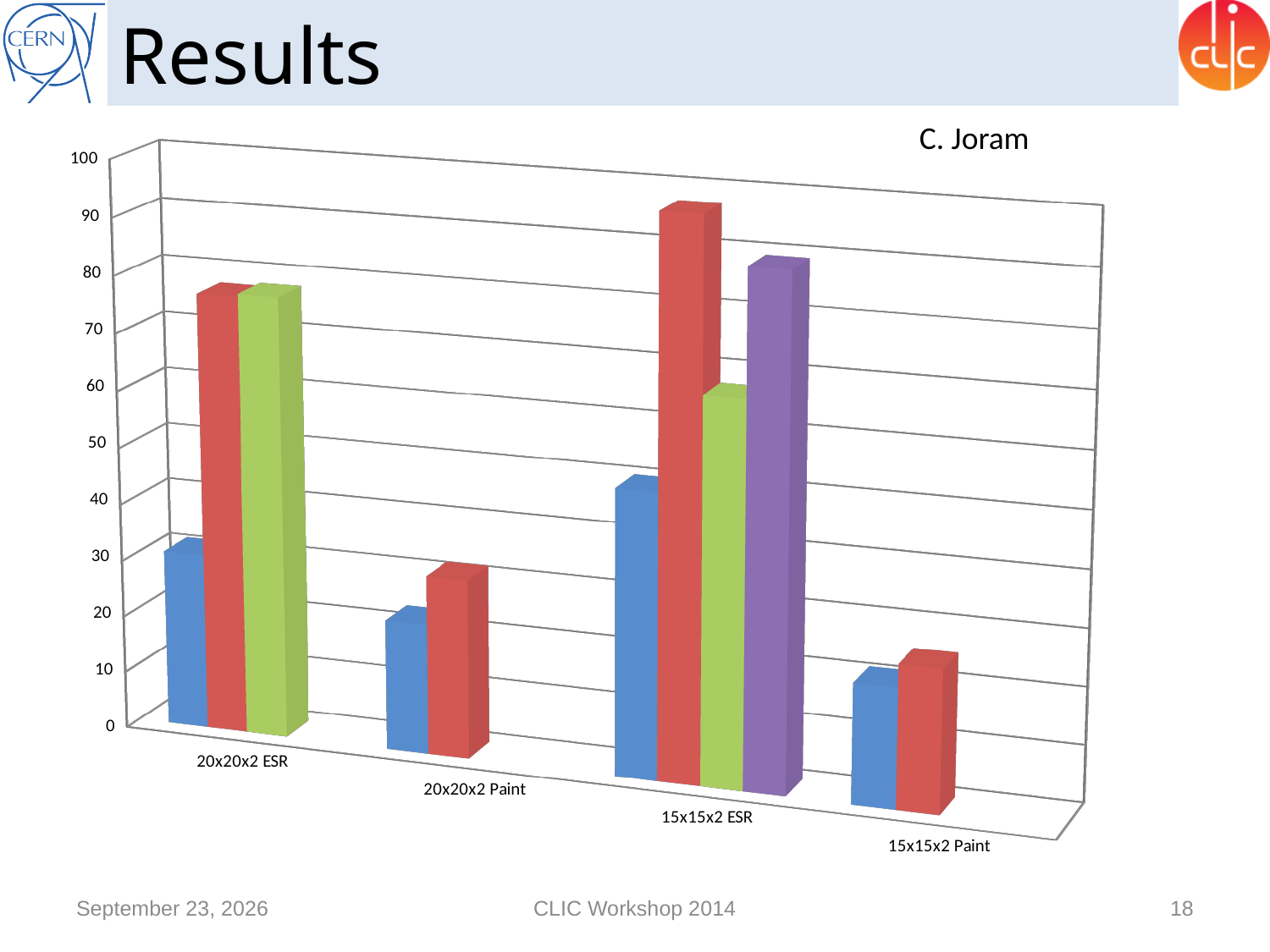
How many bars are plotted for the 20x20x2 Paint category? 2 Which category contains the shortest bar in the chart? 15x15x2 Paint What is the maximum value shown on the vertical axis of the chart? 100 What kind of chart is shown on the slide? bar chart Is the value of the red bar for 15x15x2 ESR greater or less than 70? greater How many categories are shown on the x axis of the chart? 4 How many bars are plotted for the 15x15x2 ESR category? 4 Is the value of the blue bar for 20x20x2 ESR greater or less than 20? greater In the 15x15x2 ESR category, which is larger, the green bar or the purple bar? the purple bar Which category contains the tallest bar in the chart? 15x15x2 ESR In the 20x20x2 ESR category, which is larger, the blue bar or the red bar? the red bar Is the value of the red bar for 20x20x2 Paint greater or less than 50? less